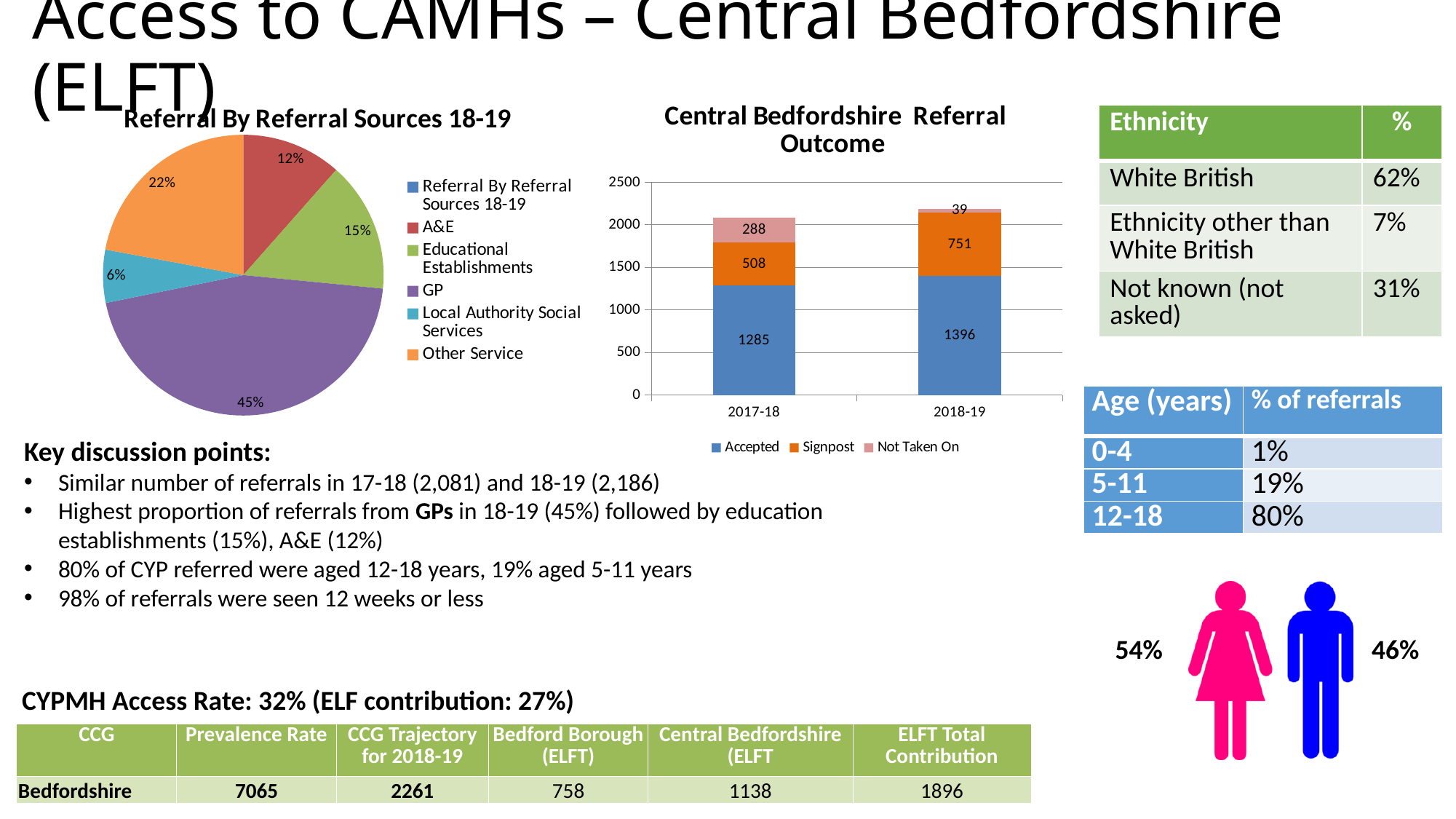
In the 'Central Bedfordshire Referral Outcome' chart, how much higher is the Signpost value in 2018-19 than in 2017-18? 243 In the pie chart 'Referral By Referral Sources 18-19', what share of referrals came from GP? 45% How many series does the legend of the 'Central Bedfordshire Referral Outcome' chart list? 3 In the 'Central Bedfordshire Referral Outcome' chart, what is the total of the 2018-19 bar? 2186 In the 'Central Bedfordshire Referral Outcome' chart, what is the Not Taken On value for 2017-18? 288 In the pie chart 'Referral By Referral Sources 18-19', what share of referrals came from Local Authority Social Services? 6% In the 'Central Bedfordshire Referral Outcome' chart, what is the Accepted value for 2018-19? 1396 What kind of chart is 'Central Bedfordshire Referral Outcome'? Stacked bar chart In the pie chart 'Referral By Referral Sources 18-19', what is the difference in percentage points between the A&E share and the Educational Establishments share? 3 percentage points In the pie chart 'Referral By Referral Sources 18-19', which referral source has the smallest share? Local Authority Social Services In the pie chart 'Referral By Referral Sources 18-19', which referral source has the largest share? GP In the pie chart 'Referral By Referral Sources 18-19', which is larger: the share for Other Service or the share for Educational Establishments? Other Service